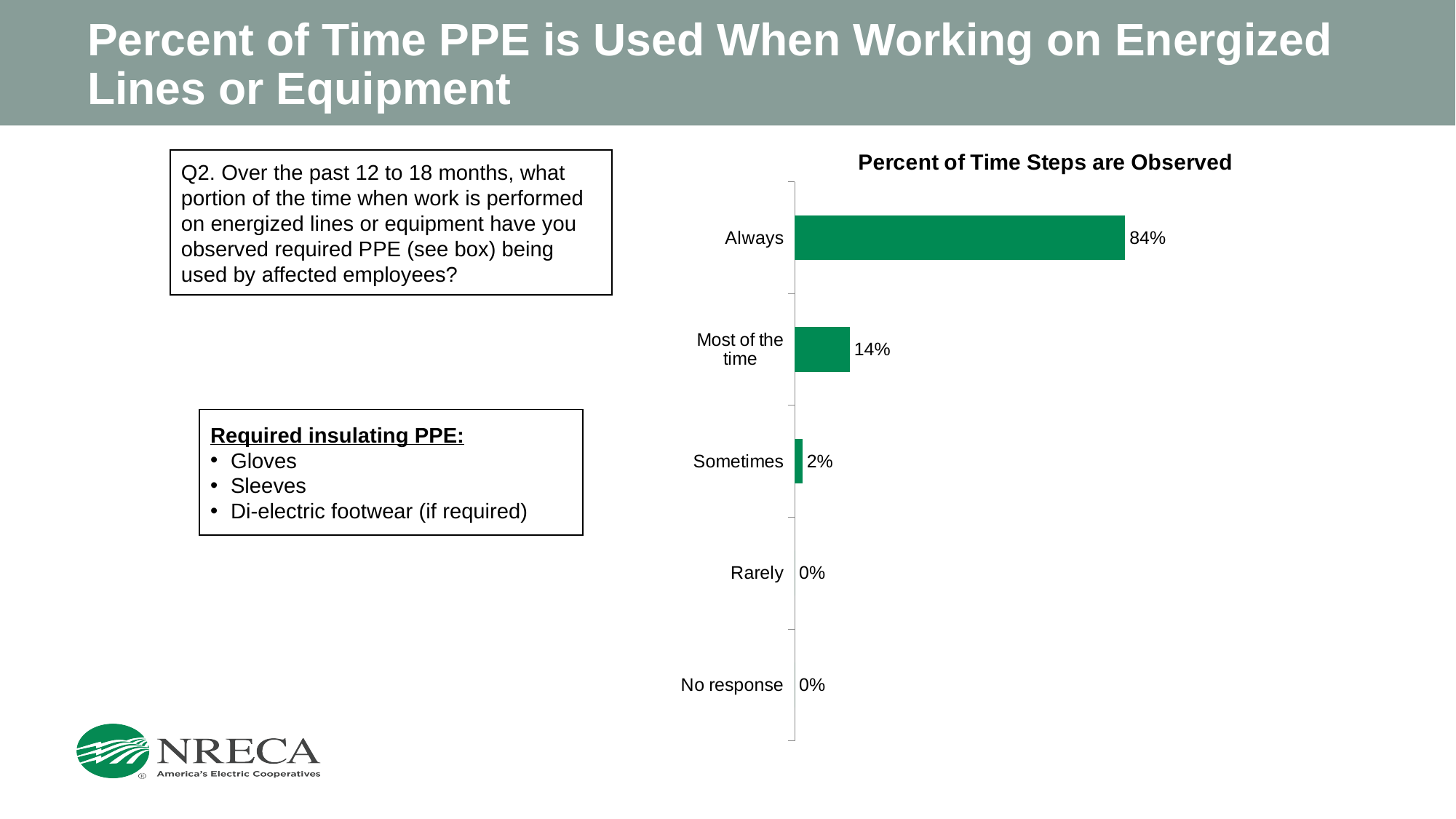
What is the value for Always? 84% Which category has the highest value? Always How many categories are shown on the chart? 5 What colour are the bars in the chart? Green What is the difference between the values for Always and Most of the time? 70% What is the value for Rarely? 0% What is the difference between the values for Most of the time and Sometimes? 12% What is the value for Most of the time? 14% Which is larger, the value for Most of the time or the value for Sometimes? Most of the time What is the value for Sometimes? 2% What kind of chart is shown on the slide? Bar chart What is the title of the chart? Percent of Time Steps are Observed